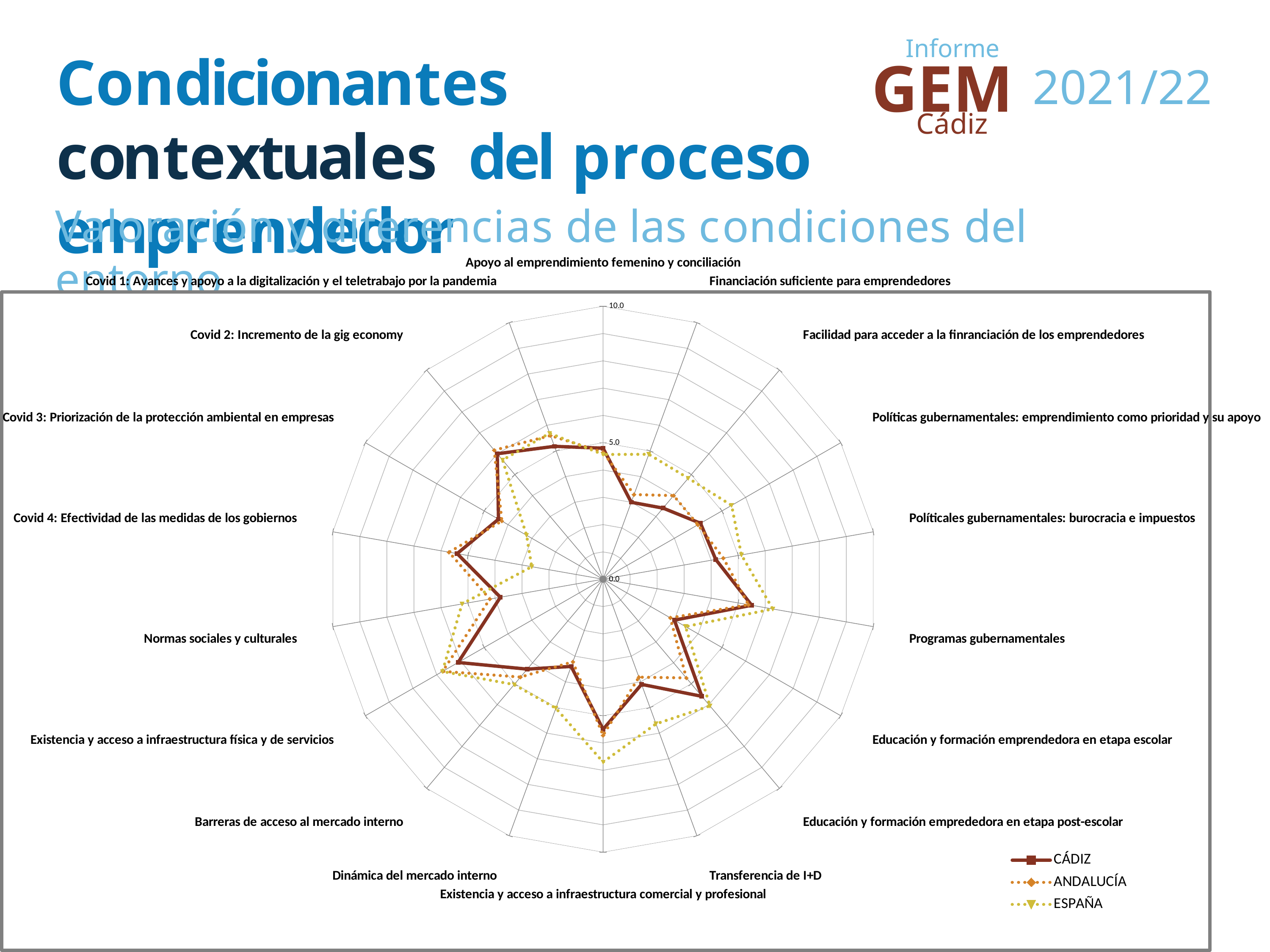
Is the CÁDIZ value for 'Educación y formación emprededora en etapa post-escolar' greater or less than 5.0? greater Is the CÁDIZ value for 'Existencia y acceso a infraestructura física y de servicios' greater or less than 5.0? greater Is the CÁDIZ value for 'Covid 2: Incremento de la gig economy' greater or less than 5.0? greater How many series does the legend list? 3 What is the maximum value shown on the radial axis? 10.0 For 'Dinámica del mercado interno', which series has the larger value, CÁDIZ or ESPAÑA? ESPAÑA Which series are listed in the legend? CÁDIZ, ANDALUCÍA, ESPAÑA For 'Covid 4: Efectividad de las medidas de los gobiernos', which series has the larger value, CÁDIZ or ESPAÑA? CÁDIZ How many categories (axes) does the radar chart have? 18 What kind of chart is shown on the slide? radar chart